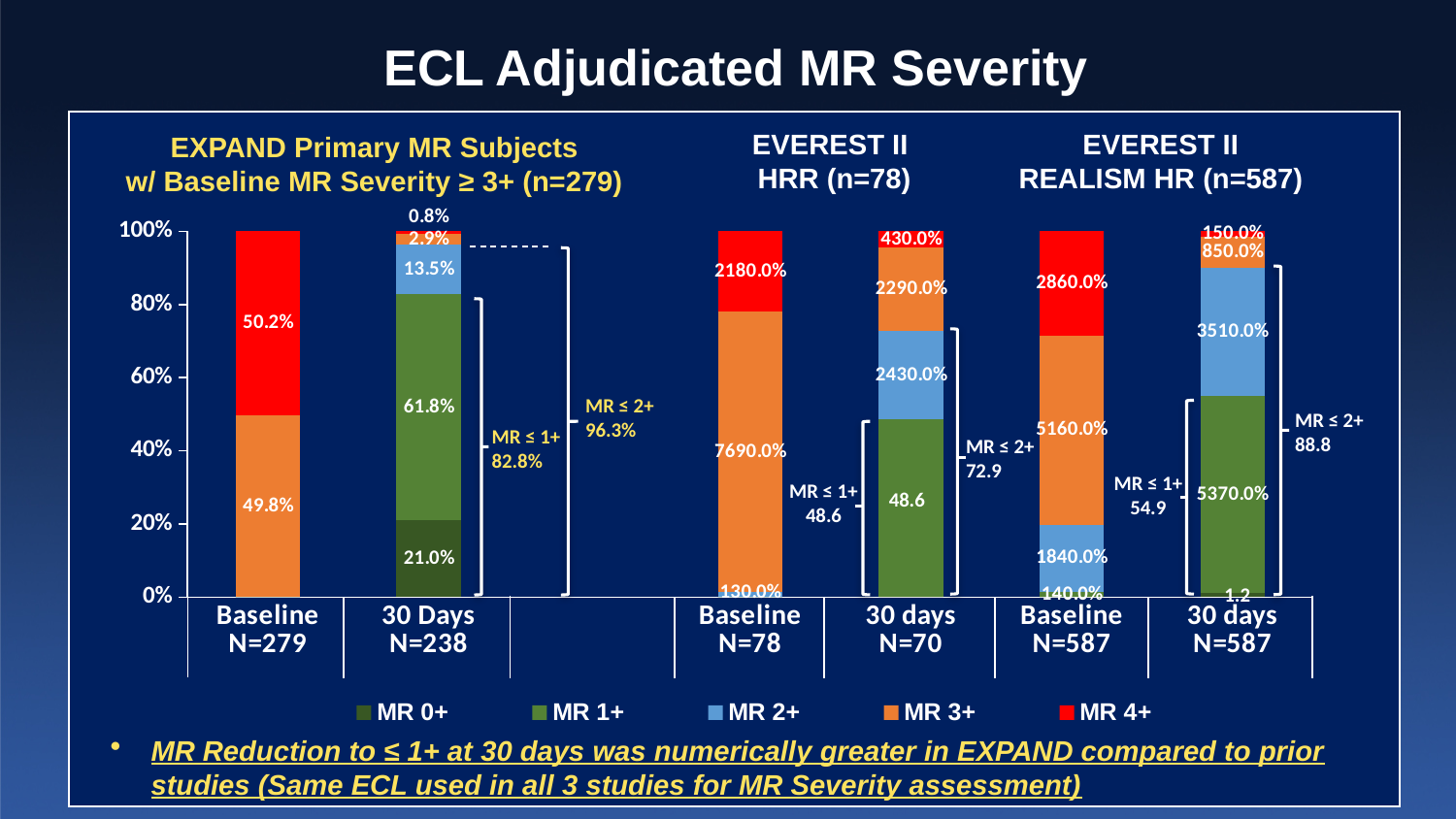
In the EXPAND 30 Days bar, what is the difference between the MR 1+ segment and the MR 2+ segment? 48.3 percentage points How many bars are plotted across the whole chart? 6 In the EXPAND Baseline bar, which segment is larger, MR 4+ or MR 3+? MR 4+ What MR ≤ 1+ value is annotated next to the EXPAND 30 Days bar? 82.8% In the EXPAND Primary MR Subjects chart, what is the value of the MR 0+ segment in the 30 Days bar? 21.0% In the EXPAND 30 Days bar, which MR category has the largest segment? MR 1+ In the EXPAND Primary MR Subjects chart, what is the value of the MR 1+ segment in the 30 Days (N=238) bar? 61.8% In the EVEREST II HRR chart, what is the label on the MR 1+ segment of the 30 days (N=70) bar? 48.6 In the EXPAND Primary MR Subjects chart, what is the value of the MR 4+ segment in the Baseline (N=279) bar? 50.2% How many series does the legend list? 5 What kind of chart is shown on the slide? Stacked bar chart In the EXPAND Primary MR Subjects chart, what is the value of the MR 4+ segment in the 30 Days bar? 0.8%